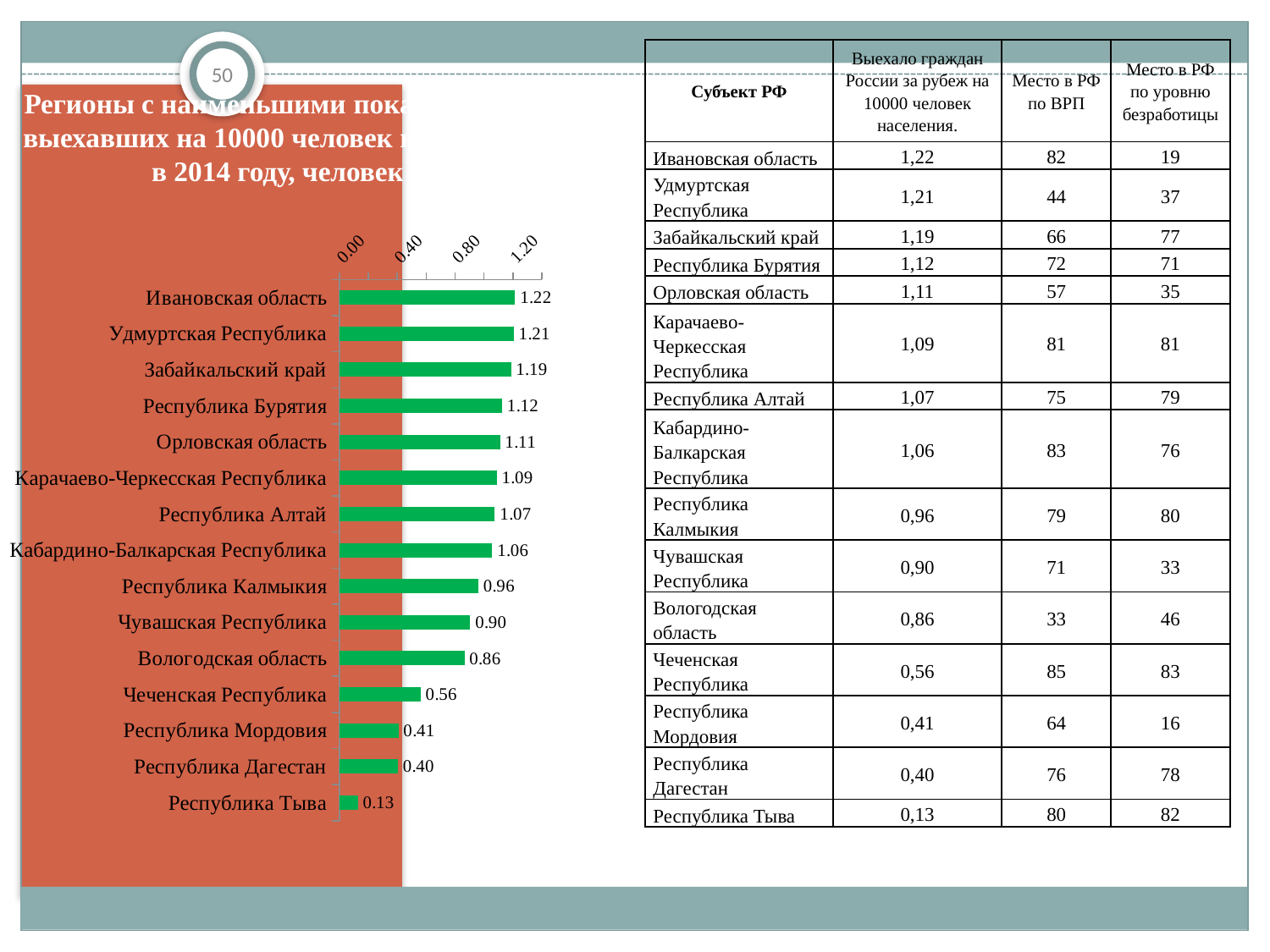
Which region has the highest value in the bar chart? Ивановская область What is the value for Республика Калмыкия in the bar chart? 0.96 Which region has the lowest value in the bar chart? Республика Тыва What is the value for Чеченская Республика in the bar chart? 0.56 What is the difference between the values for Ивановская область and Республика Тыва in the bar chart? 1.09 What colour are the bars in the chart? green Which has a larger value in the bar chart, Республика Бурятия or Республика Мордовия? Республика Бурятия What is the value for Ивановская область in the bar chart? 1.22 What kind of chart is shown on the slide? bar chart What is the difference between the values for Вологодская область and Чеченская Республика in the bar chart? 0.30 How many regions are shown in the bar chart? 15 Is the value for Чувашская Республика in the bar chart greater or less than 0.80? greater